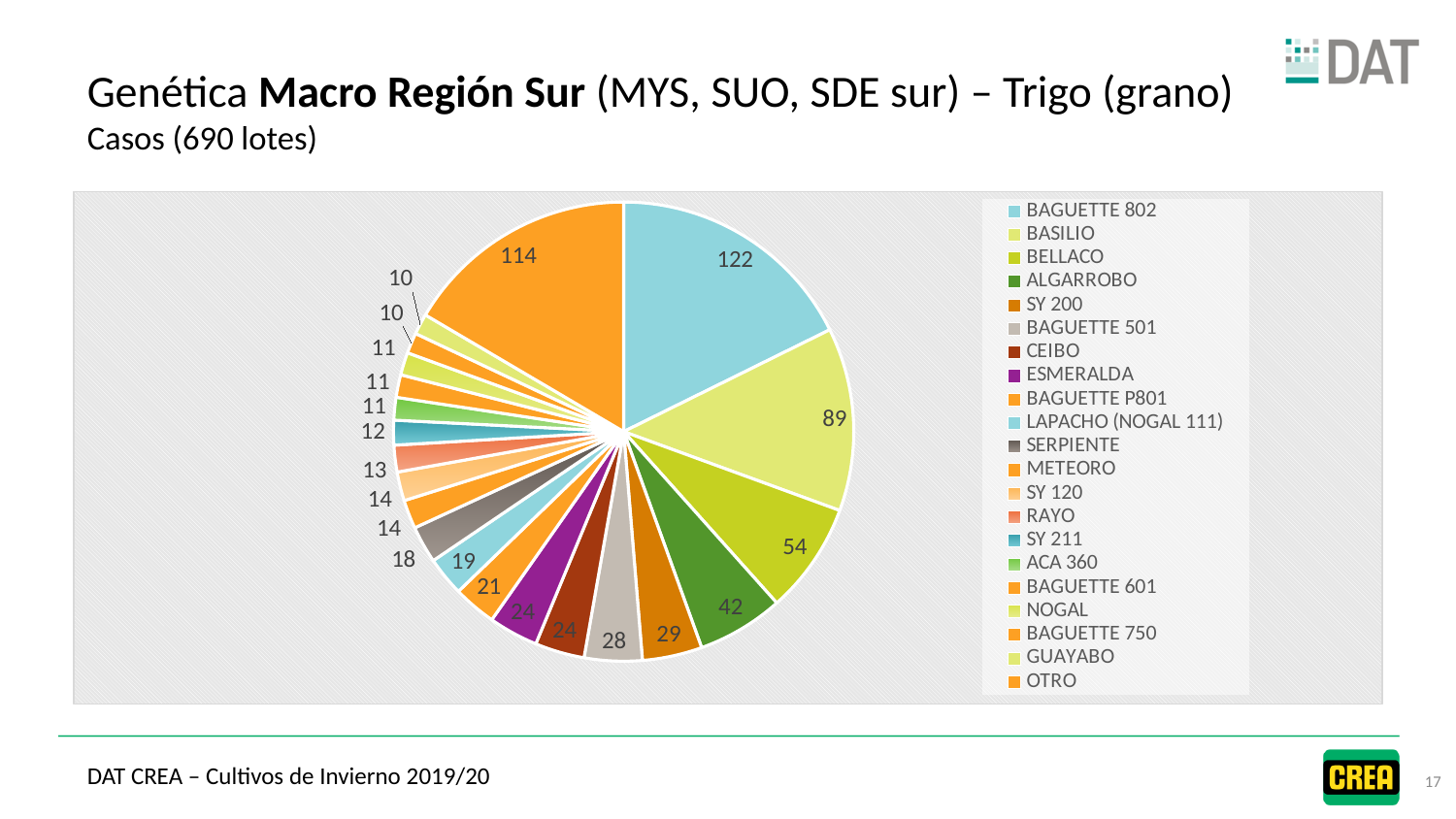
How many entries does the legend list? 21 What type of chart is shown on the slide? pie chart What is the value shown for BASILIO? 89 What is the value shown for ALGARROBO? 42 Which named variety has the largest slice of the pie? BAGUETTE 802 What is the value shown for the OTRO slice? 114 What share of the 690 lotes does BAGUETTE 802 represent? 17.7% According to the subtitle, how many lotes (cases) does the chart cover in total? 690 lotes How many cases (lotes) does the BAGUETTE 802 slice represent? 122 What is the difference between the values for BAGUETTE 802 and BASILIO? 33 Which is larger, the value for BELLACO or the value for ALGARROBO? BELLACO What is the value shown for BELLACO? 54